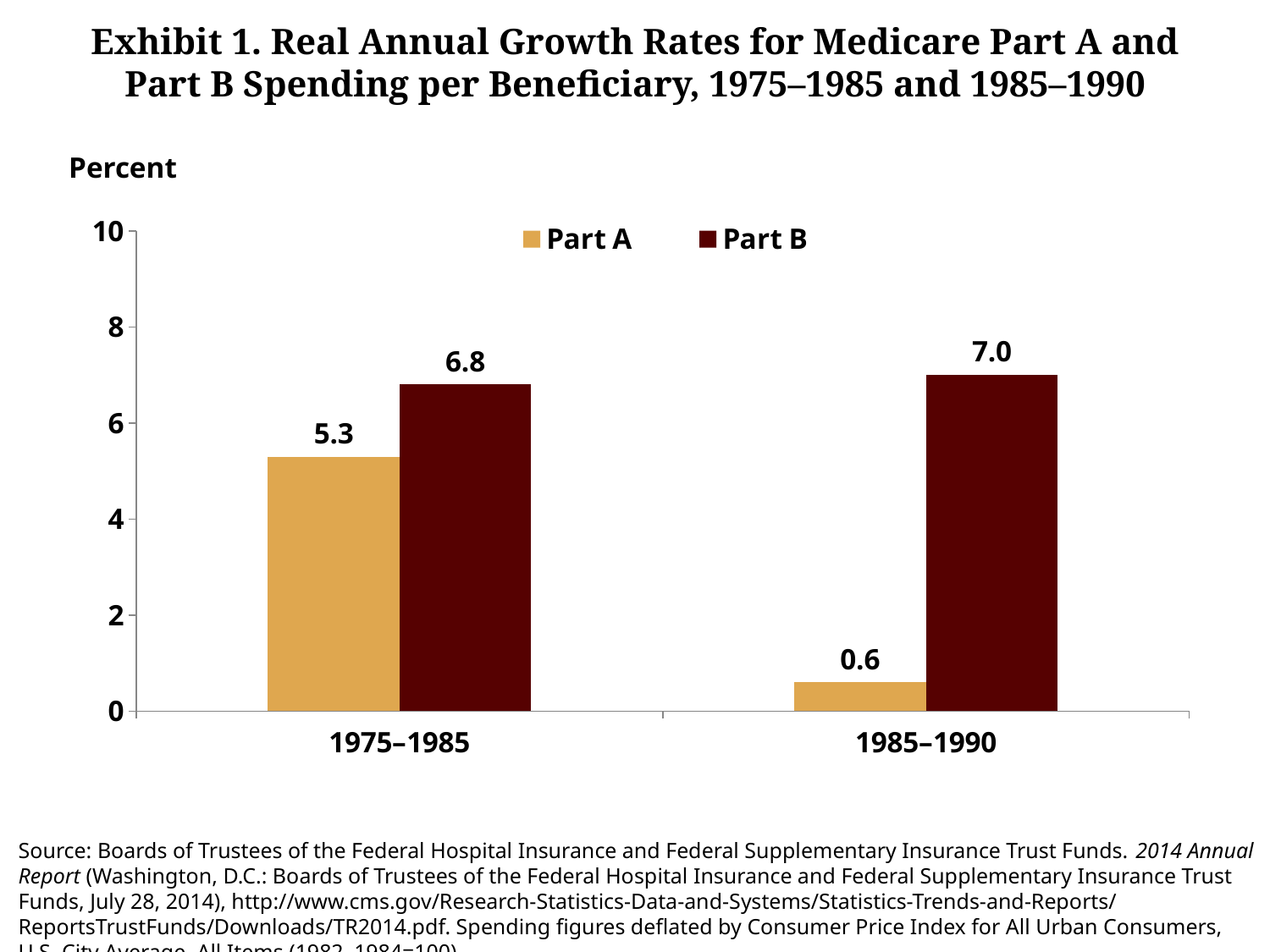
Which period has the lowest Part A growth rate? 1985–1990 What is the Part B growth rate for 1985–1990? 7.0 What is the difference between the Part A growth rates for 1975–1985 and 1985–1990? 4.7 What kind of chart is shown? Bar chart Which is larger for 1985–1990, Part A or Part B? Part B What is the difference between the Part B and Part A growth rates for 1975–1985? 1.5 What is the label on the vertical axis? Percent Which period has the highest Part B growth rate? 1985–1990 What is the Part A growth rate for 1985–1990? 0.6 What is the Part A growth rate for 1975–1985? 5.3 What is the Part B growth rate for 1975–1985? 6.8 How many series does the legend list? 2